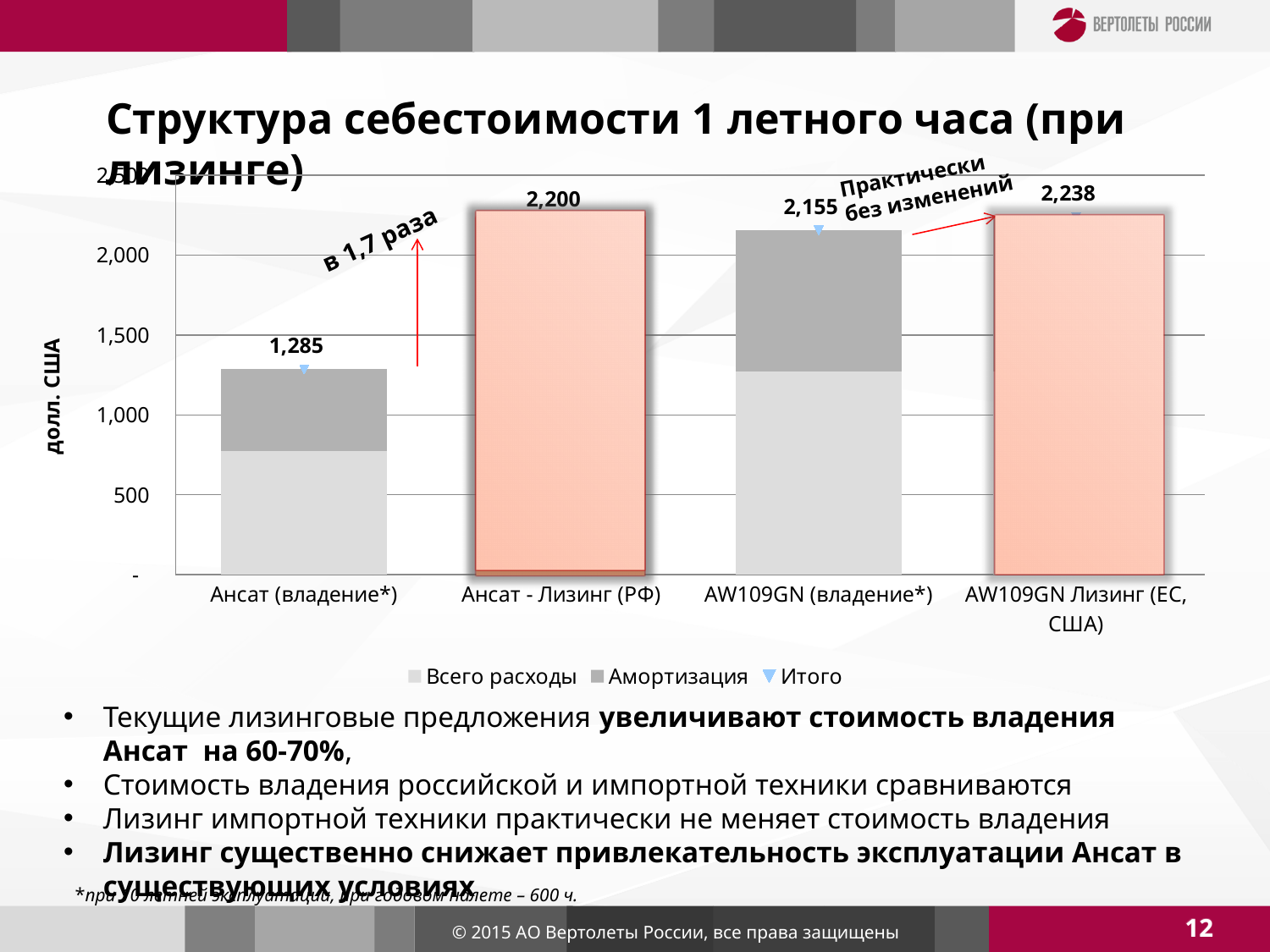
What is the label of the vertical axis? долл. США Which is larger, the total for Ансат - Лизинг (РФ) or for AW109GN (владение*)? Ансат - Лизинг (РФ) How many categories are shown on the x axis? 4 Is the total value for Ансат (владение*) greater or less than 1,500? less What is the total value labelled for Ансат - Лизинг (РФ)? 2,200 What is the total value labelled for AW109GN Лизинг (ЕС, США)? 2,238 Which category has the highest total value? AW109GN Лизинг (ЕС, США) What is the difference between the totals for Ансат - Лизинг (РФ) and Ансат (владение*)? 915 How many series does the legend list? 3 Which category has the lowest total value? Ансат (владение*) What is the total value labelled for Ансат (владение*)? 1,285 What is the total value labelled for AW109GN (владение*)? 2,155